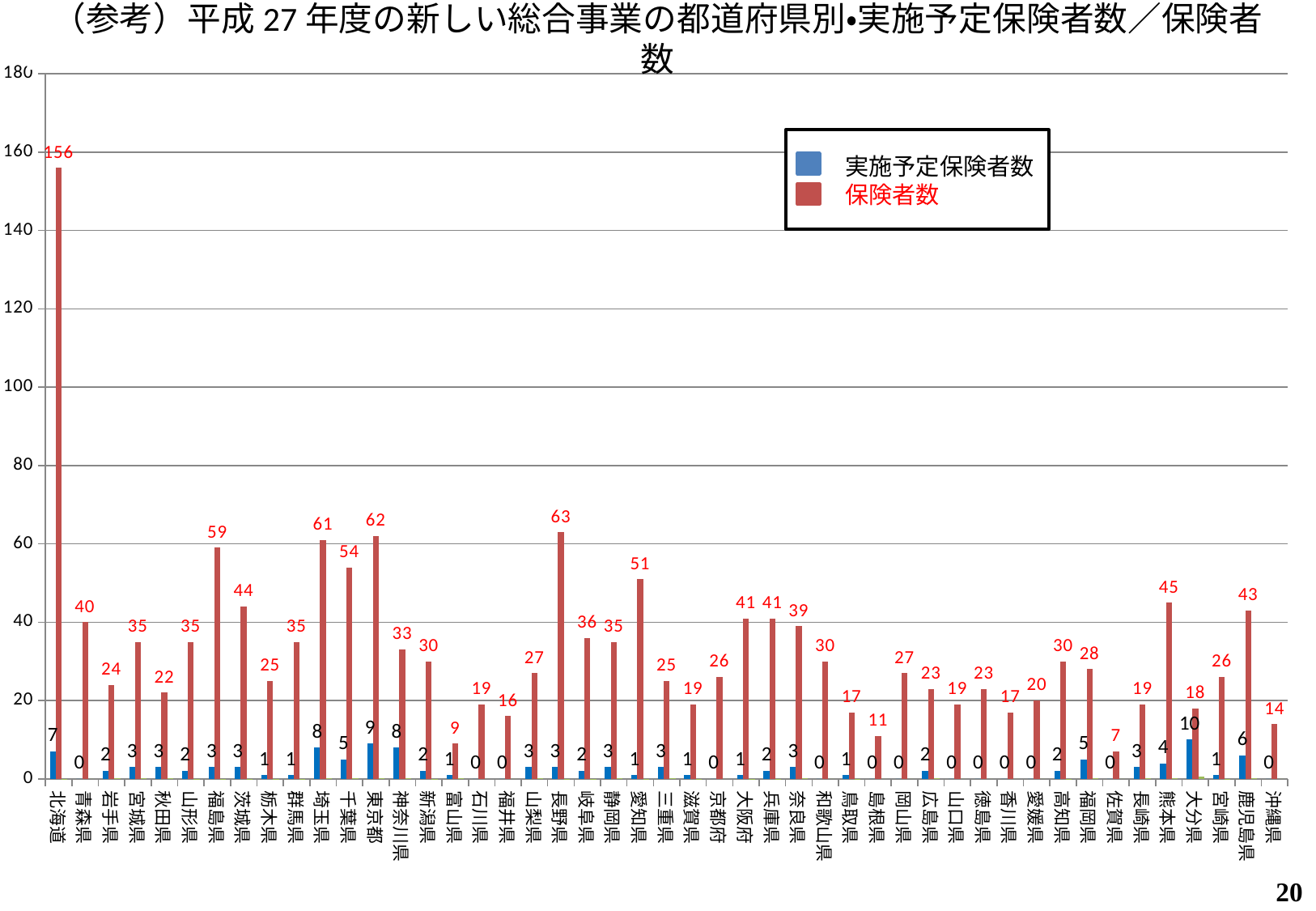
What is the 保険者数 value for 北海道? 156 Which has a larger 保険者数, 福島県 or 茨城県? 福島県 What are the two legend entries of the chart? 実施予定保険者数 and 保険者数 How many series does the legend list? 2 Which prefecture has the highest 保険者数? 北海道 How many prefectures (categories) are shown on the x axis? 47 Which prefecture has the highest 実施予定保険者数? 大分県 What is the difference between the 保険者数 of 東京都 and 埼玉県? 1 What kind of chart is shown on the slide? bar chart What is the 実施予定保険者数 value for 東京都? 9 What is the 保険者数 value for 長野県? 63 Which prefecture has the lowest 保険者数? 佐賀県